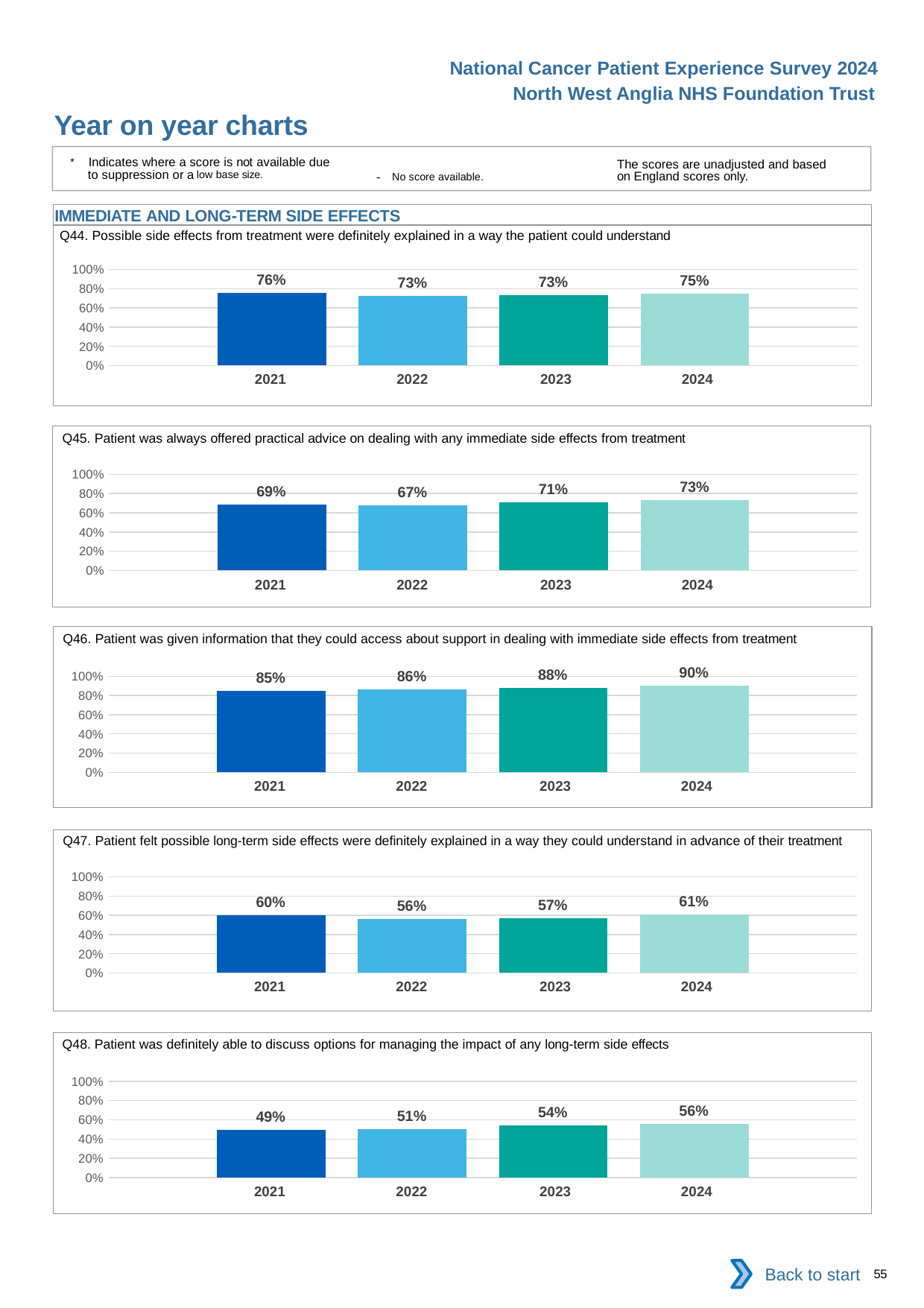
In the Q45 chart, what is the difference between the 2024 and 2021 values? 4 percentage points What kind of chart is the Q44 chart? bar chart In the Q47 chart, which is larger, the value for 2022 or the value for 2023? 2023 In the Q44 chart, which year has the highest value? 2021 In the Q48 chart, what is the value for 2023? 54% In the Q46 chart, which year has the lowest value? 2021 In the Q45 chart, what is the value for 2022? 67% In the Q48 chart, is the value for 2021 greater or less than 60%? less In the Q44 chart, what is the value for 2021? 76% How many years are shown on the x axis of the Q48 chart? 4 In the Q47 chart, what is the value for 2024? 61% In the Q46 chart, do the values rise or fall from 2021 to 2024? rise